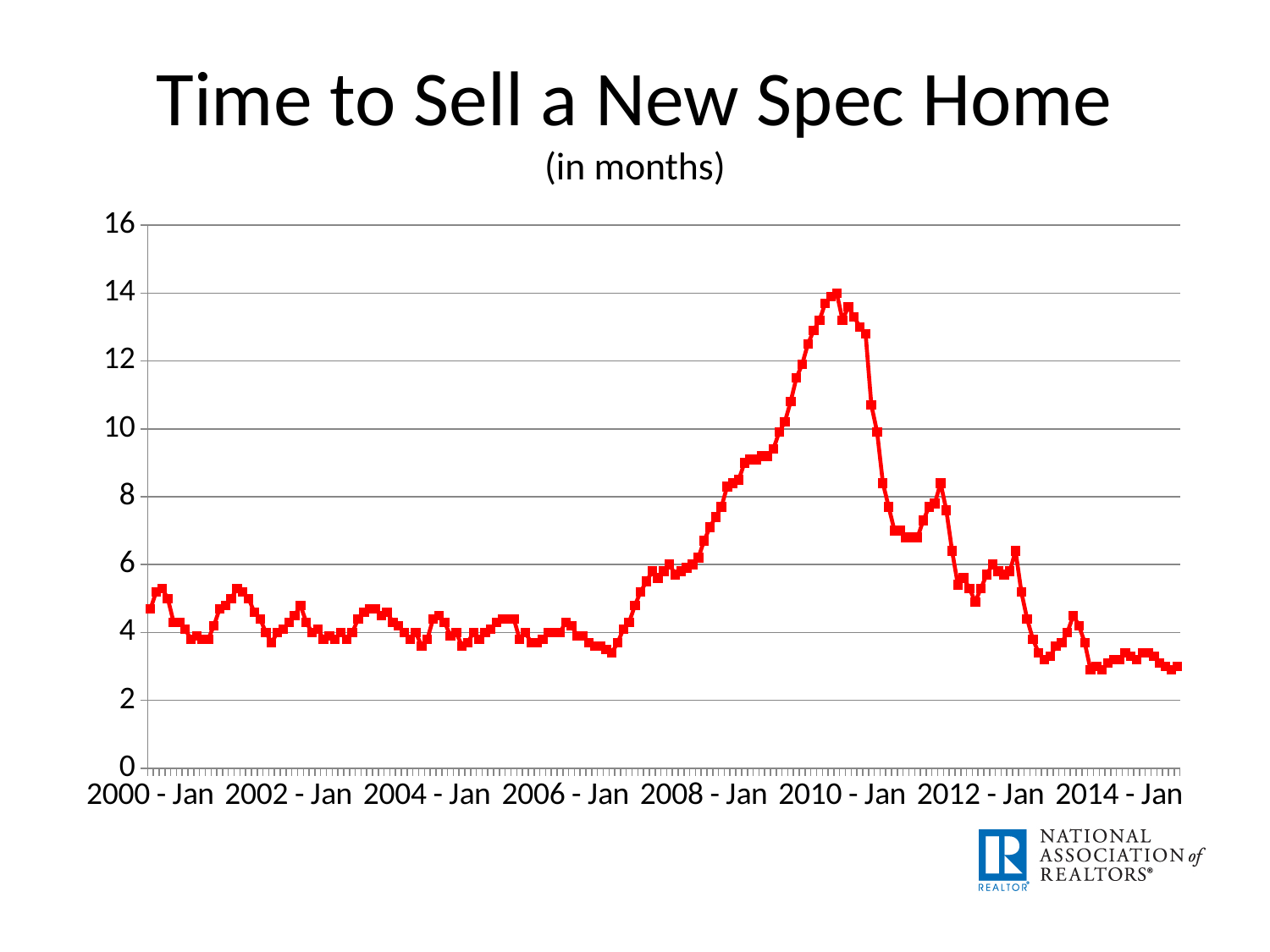
Does the line rise or fall between 2010 - Jan and 2012 - Jan? fall Is the value at 2014 - Jan greater or less than 4? less Is the value at 2004 - Jan greater or less than 6? less What kind of chart is shown on the slide? line chart Which is larger, the value at 2010 - Jan or the value at 2014 - Jan? 2010 - Jan What is the title of the chart? Time to Sell a New Spec Home Is the value at 2000 - Jan greater or less than 6? less Near which labelled x-axis date does the line reach its highest point? 2010 - Jan Does the line rise or fall between 2008 - Jan and 2010 - Jan? rise In what units are the values on the chart measured, according to the subtitle? months